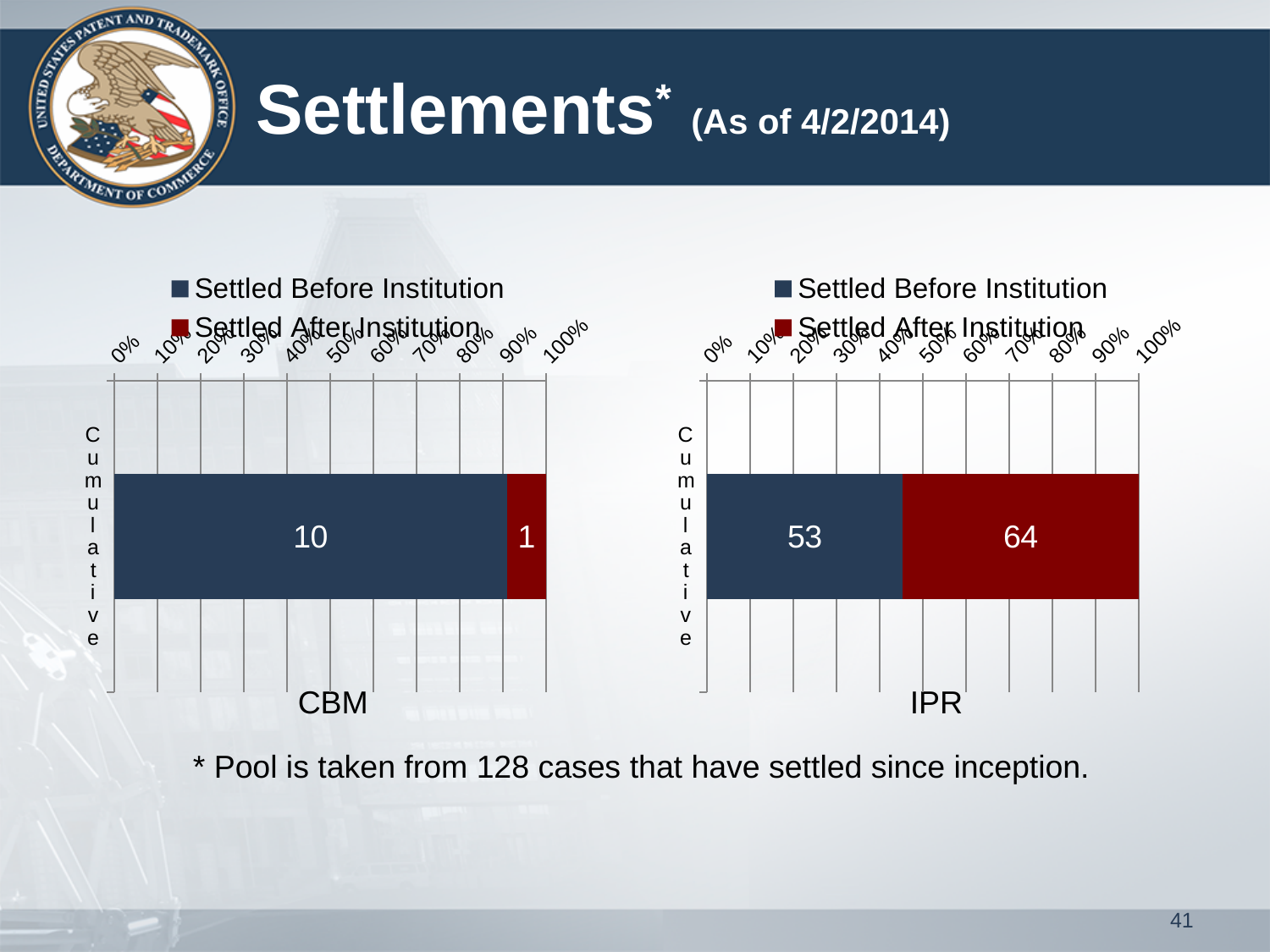
How many series does the legend of the IPR chart on the right list? 2 In the CBM chart on the left, what is the value for Settled After Institution? 1 In the CBM chart on the left, what is the total of the two segments in the stacked bar? 11 In the IPR chart on the right, what is the difference between Settled After Institution and Settled Before Institution? 11 In the IPR chart on the right, what is the total of the two segments in the stacked bar? 117 In the IPR chart on the right, which series has the larger value, Settled Before Institution or Settled After Institution? Settled After Institution In the CBM chart on the left, which series has the smaller value? Settled After Institution What kind of chart is the CBM chart on the left? Bar chart In the CBM chart on the left, what is the value for Settled Before Institution? 10 In the IPR chart on the right, what is the value for Settled Before Institution? 53 In the IPR chart on the right, what is the value for Settled After Institution? 64 In the CBM chart on the left, which colour represents Settled After Institution? Red